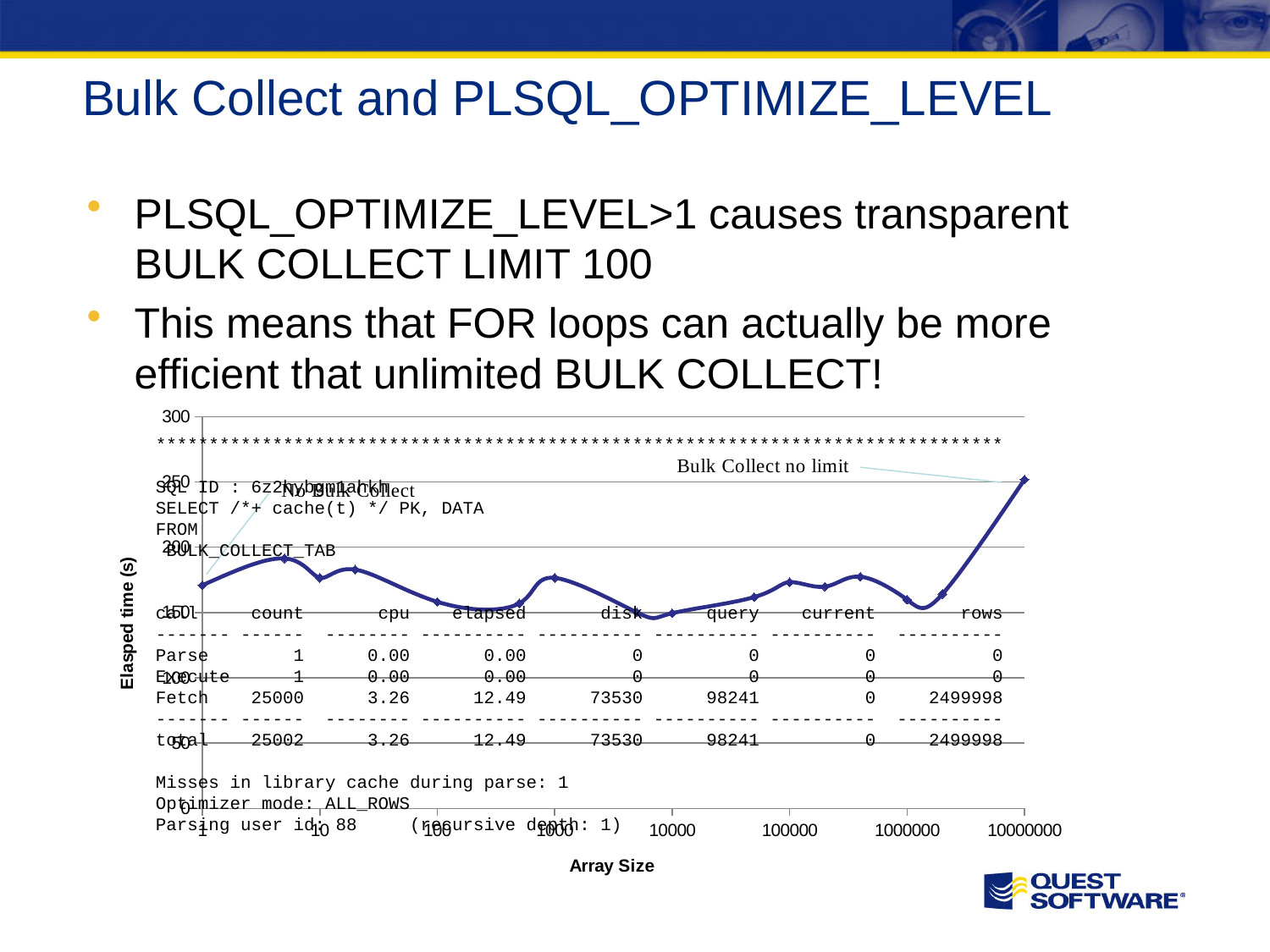
Is the elapsed time at array size 10000000 greater or less than 200? greater Does the elapsed time rise or fall between array size 1000000 and array size 10000000? rise Is the elapsed time at array size 10000000 greater or less than 300? less What is the title of the y axis of the chart? Elasped time (s) What kind of chart is shown on the slide? line chart What is the title of the x axis of the chart? Array Size Is the elapsed time at array size 1 greater or less than 200? less At which array size is the elapsed time highest? 10000000 How many tick labels are shown on the x axis of the chart? 8 Which has the larger elapsed time, array size 1 or array size 10? 10 What is the highest value shown on the y axis of the chart? 300